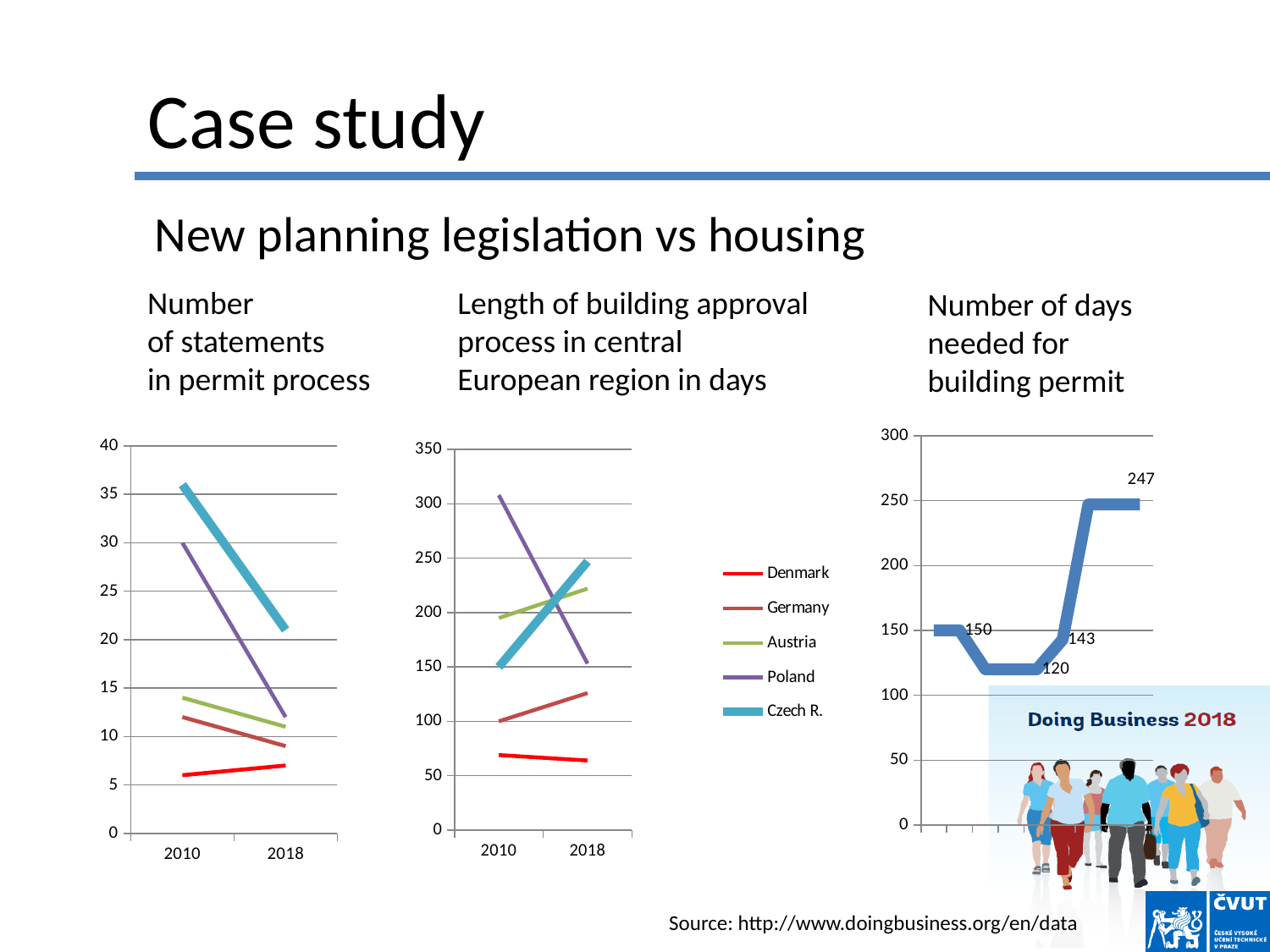
In the middle chart 'Length of building approval process in central European region in days', which country has the lowest value in 2018? Denmark In the left chart 'Number of statements in permit process', does the value for Czech R. rise or fall from 2010 to 2018? fall In the left chart 'Number of statements in permit process', is the value for Czech R. in 2010 greater or less than 30? greater In the right chart 'Number of days needed for building permit', what is the difference between the labeled values 247 and 143? 104 In the right chart 'Number of days needed for building permit', what is the highest labeled value? 247 In the middle chart 'Length of building approval process in central European region in days', is the value for Poland in 2010 greater or less than 250? greater In the middle chart 'Length of building approval process in central European region in days', which is larger in 2010: Poland or Czech R.? Poland How many series does the shared legend list? 5 In the shared legend, what colour is the line for Denmark? red In the middle chart 'Length of building approval process in central European region in days', does the value for Czech R. rise or fall from 2010 to 2018? rise In the left chart 'Number of statements in permit process', is the value for Poland in 2018 greater or less than 15? less What kind of chart is the left chart, 'Number of statements in permit process'? line chart